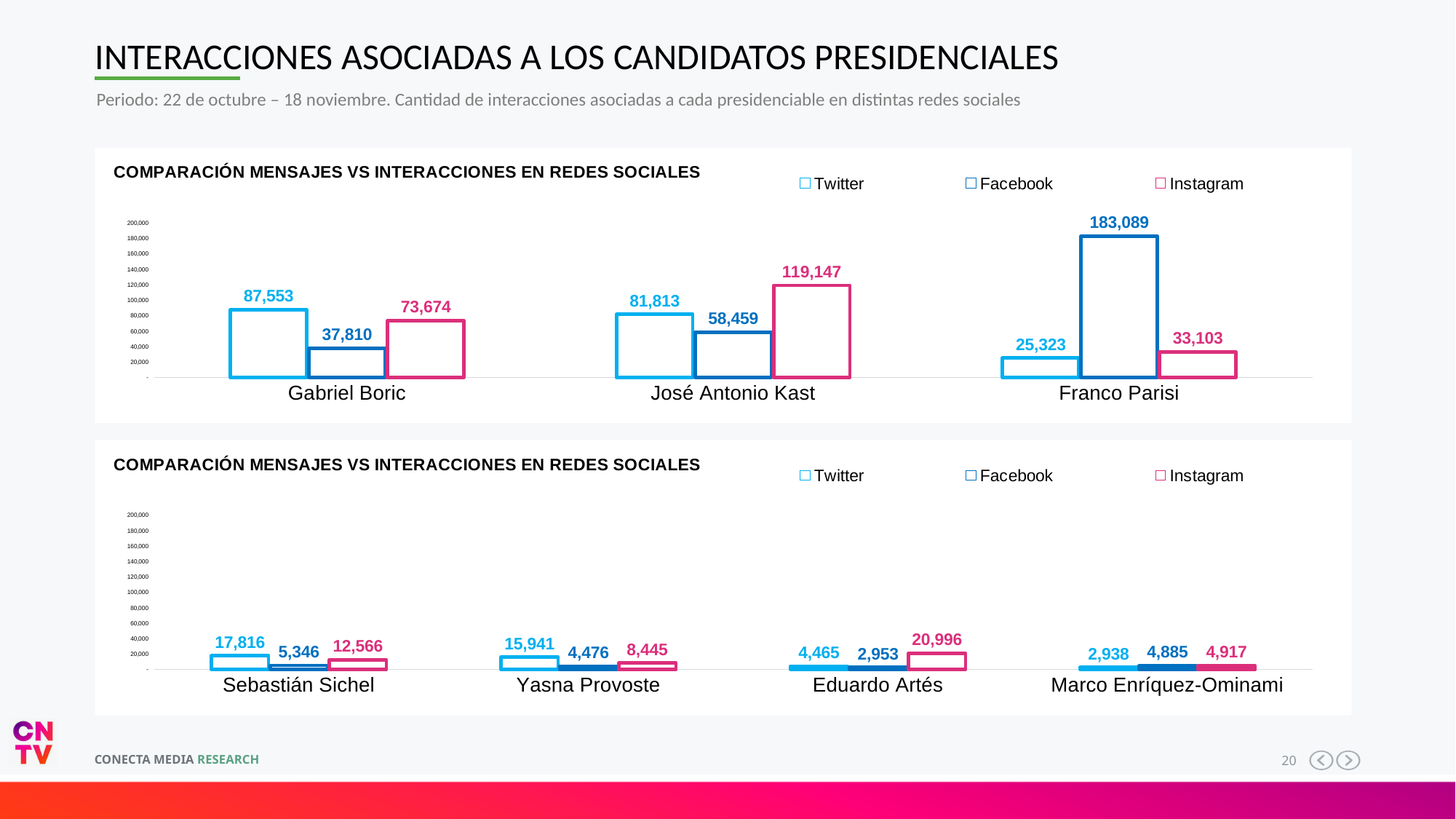
In the top chart, what is the difference between the Twitter and Facebook values for Gabriel Boric? 49,743 What type of chart is the top chart? Bar chart In the top chart, is the Facebook value for Franco Parisi greater or less than 160,000? greater How many series does the legend of the top chart list? 3 How many candidates are shown in the bottom chart? 4 In the bottom chart, which candidate has the lowest Twitter value? Marco Enríquez-Ominami In the bottom chart, what is the Twitter value for Sebastián Sichel? 17,816 In the top chart, which candidate has the highest Twitter value? Gabriel Boric In the bottom chart, which is larger for Yasna Provoste: the Twitter value or the Instagram value? Twitter In the top chart, what is the Instagram value for José Antonio Kast? 119,147 In the top chart, what is the Facebook value for Franco Parisi? 183,089 In the bottom chart, what is the Instagram value for Eduardo Artés? 20,996